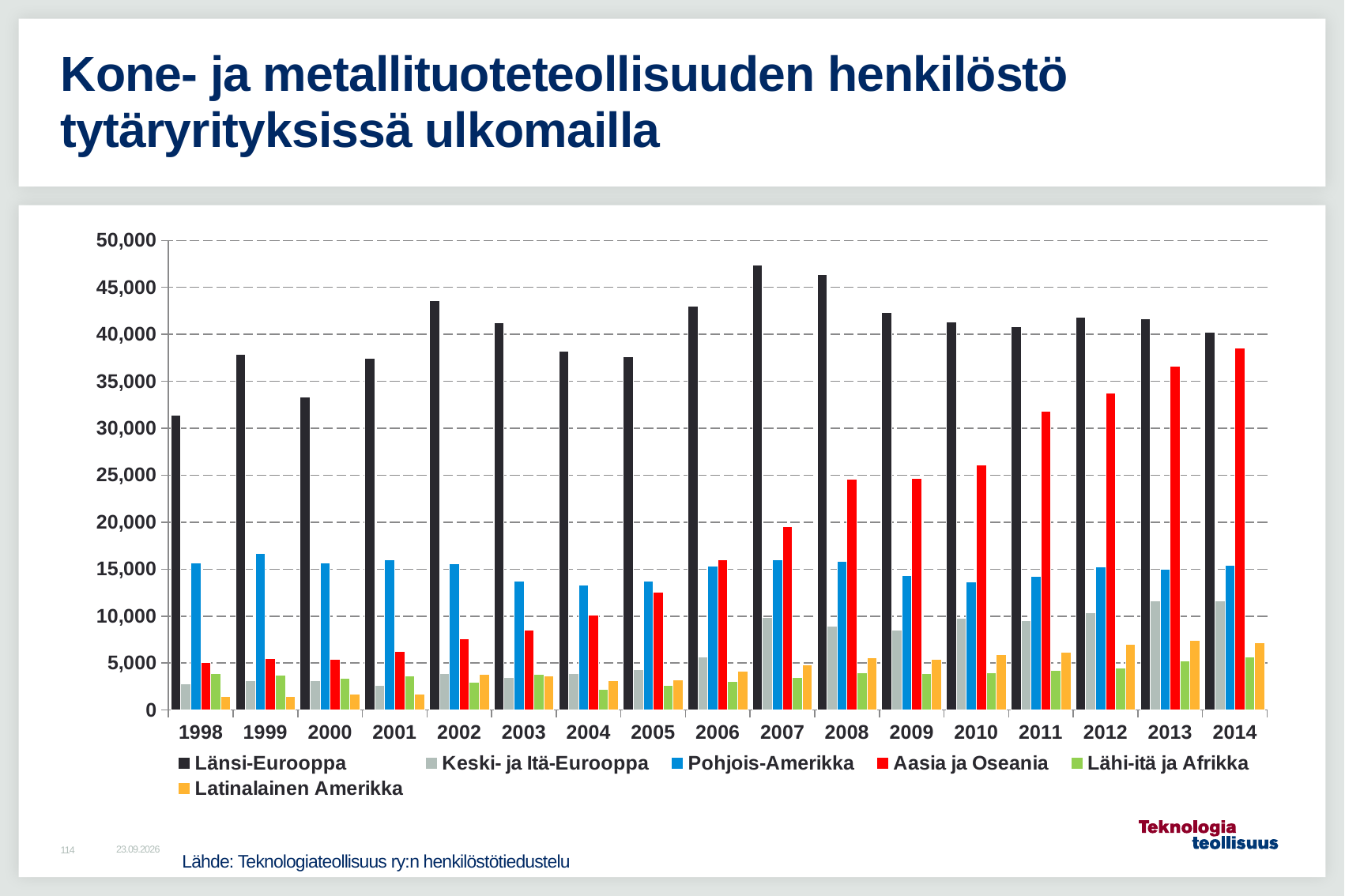
How many years are shown on the x axis? 17 Is the value for Aasia ja Oseania in 2014 greater or less than 35,000? greater In which year is the value for Länsi-Eurooppa lowest? 1998 In which year is the value for Aasia ja Oseania highest? 2014 What kind of chart is shown on the slide? bar chart Is the value for Länsi-Eurooppa in 2007 greater or less than 45,000? greater How many series does the legend list? 6 Is the value for Latinalainen Amerikka in 1998 greater or less than 5,000? less Does the value for Aasia ja Oseania generally rise or fall from 1998 to 2014? rise In which year is the value for Länsi-Eurooppa highest? 2007 In 2014, which is larger: Länsi-Eurooppa or Aasia ja Oseania? Länsi-Eurooppa